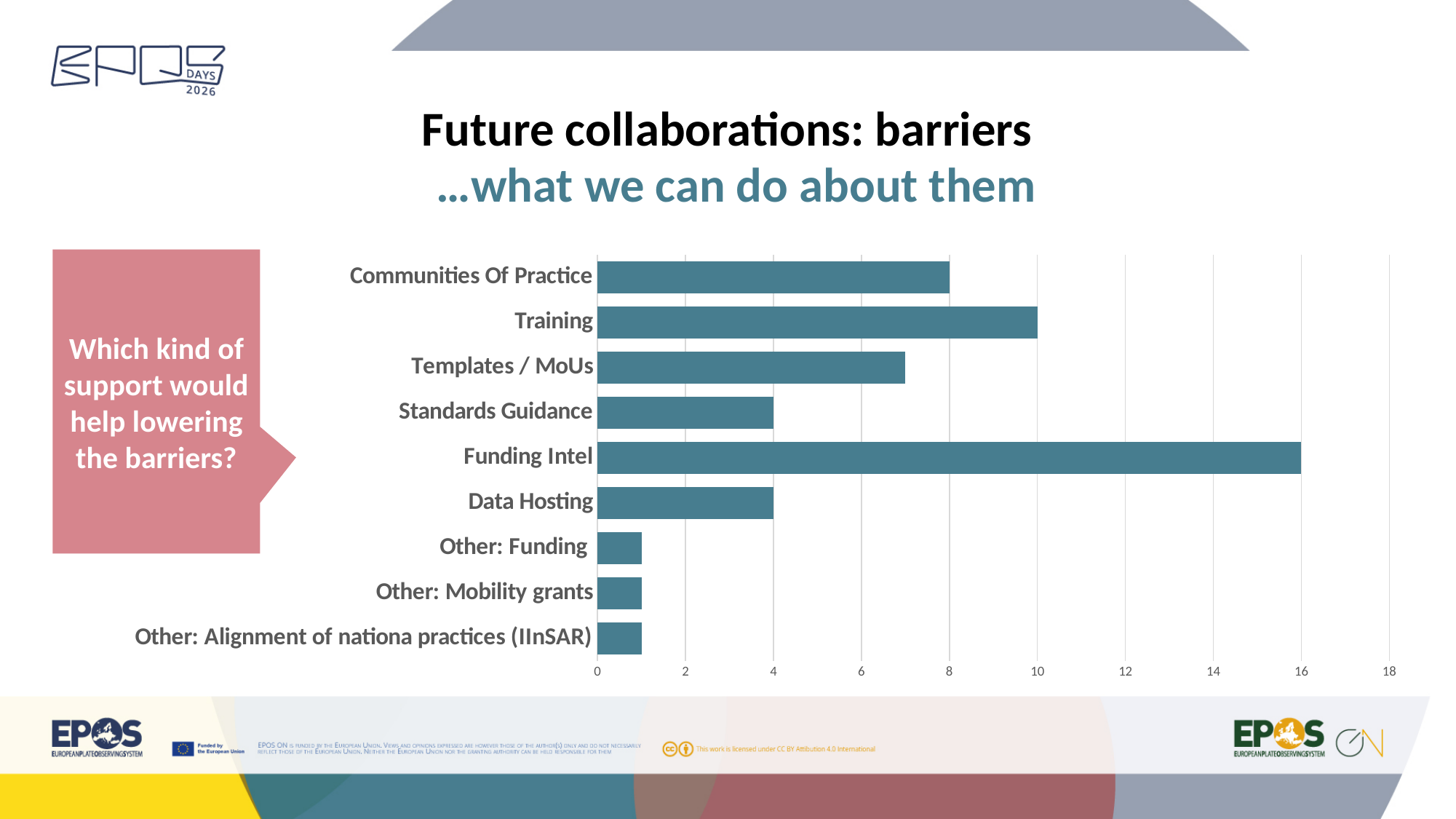
Which category has the highest value in the chart? Funding Intel Which is larger, the value for Training or the value for Communities Of Practice? Training How many categories are plotted in the chart? 9 What is the value for Training? 10 What is the value for Communities Of Practice? 8 What question is written in the red box to the left of the chart? Which kind of support would help lowering the barriers? What is the difference between the values for Funding Intel and Training? 6 Is the value for Templates / MoUs greater or less than 6? greater What is the value for Funding Intel? 16 What kind of chart is shown on the slide? bar chart Is the value for Other: Mobility grants greater or less than 2? less What is the value for Standards Guidance? 4